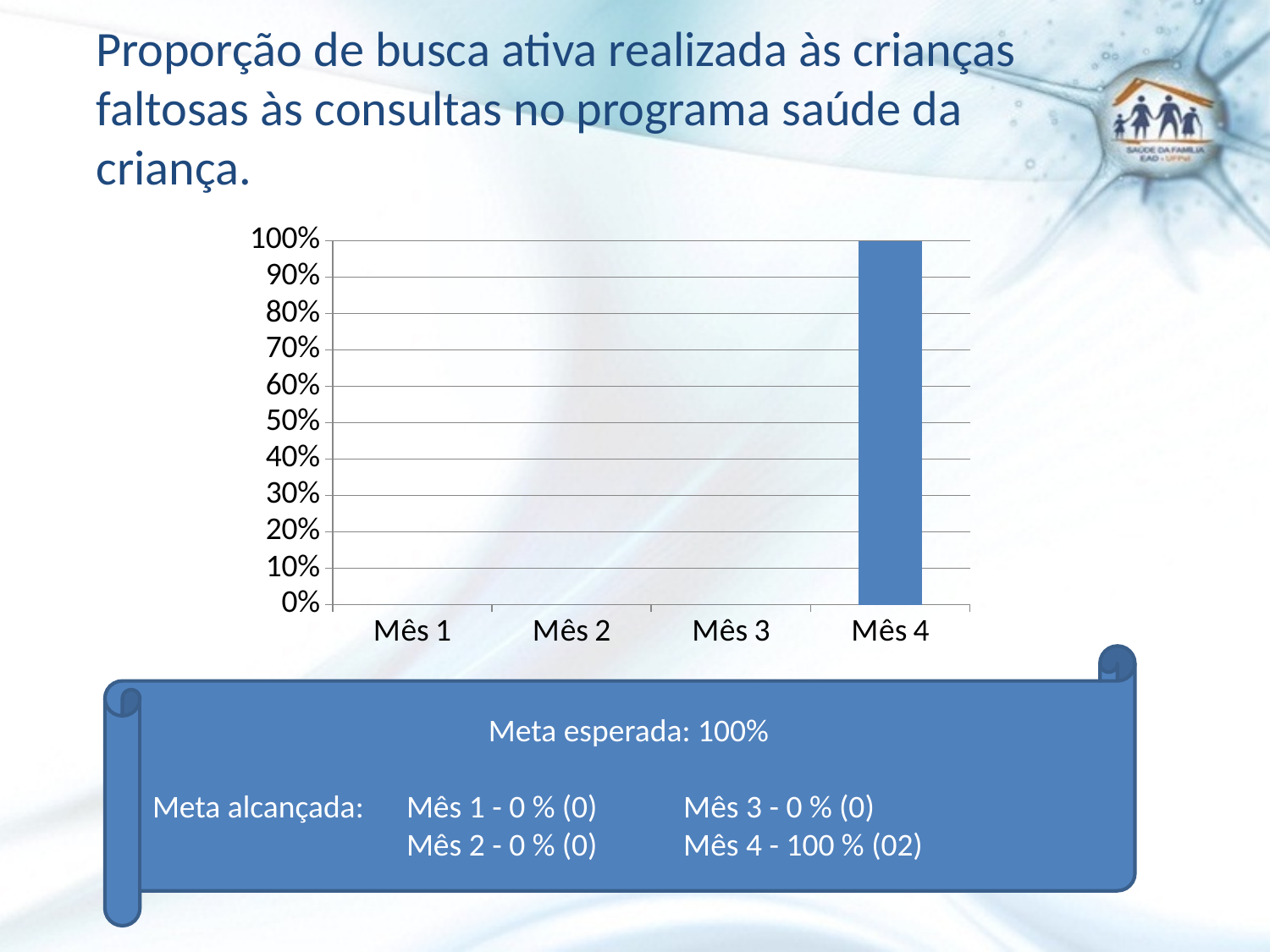
What is the maximum value shown on the y axis of the chart? 100% What is the value for Mês 2 in the chart? 0% What is the value for Mês 1 in the chart? 0% Is the value for Mês 4 greater or less than 50%? greater What kind of chart is shown on the slide? bar chart Which is larger, the value for Mês 4 or the value for Mês 1? Mês 4 What is the value for Mês 3 in the chart? 0% How many categories are shown on the x axis of the chart? 4 Do the values rise or fall from Mês 3 to Mês 4? rise What is the difference between the values for Mês 4 and Mês 3? 100% What is the value for Mês 4 in the chart? 100% Which category has the highest value in the chart? Mês 4